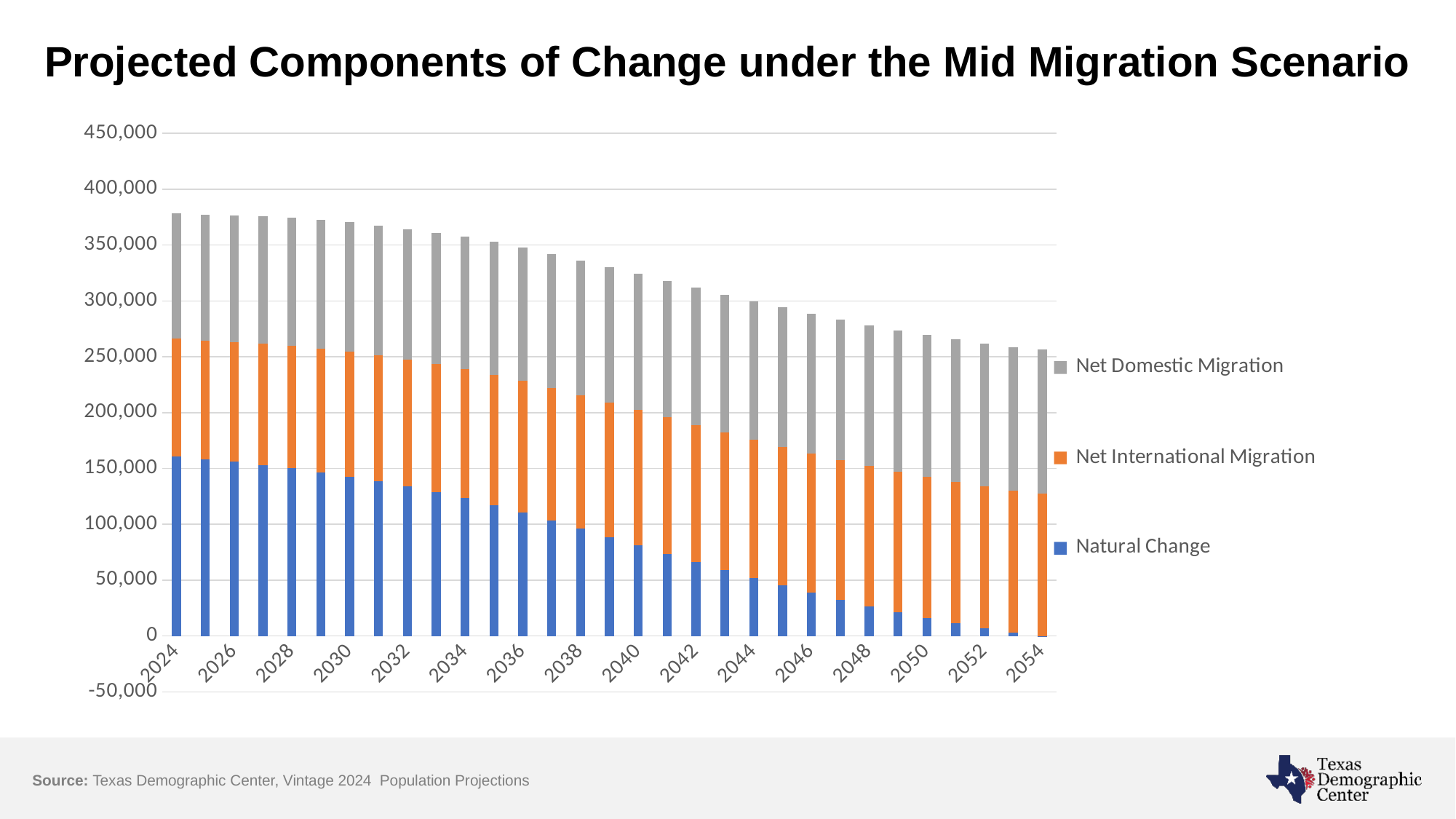
How many series does the legend list? 3 Is the Natural Change value for 2024 greater or less than 150,000? greater Which year has the shortest total bar? 2054 Is the Natural Change value for 2050 greater or less than 50,000? less Is the total bar for 2054 greater or less than 300,000? less Which series are listed in the legend? Net Domestic Migration, Net International Migration, Natural Change Which year has the larger Natural Change value, 2024 or 2054? 2024 Do the total bar heights rise or fall from 2024 to 2054? Fall How many years (bars) are plotted on the x axis from 2024 to 2054? 31 What kind of chart is shown on the slide? Stacked bar chart Which year has the tallest total bar? 2024 What is the title of the chart? Projected Components of Change under the Mid Migration Scenario